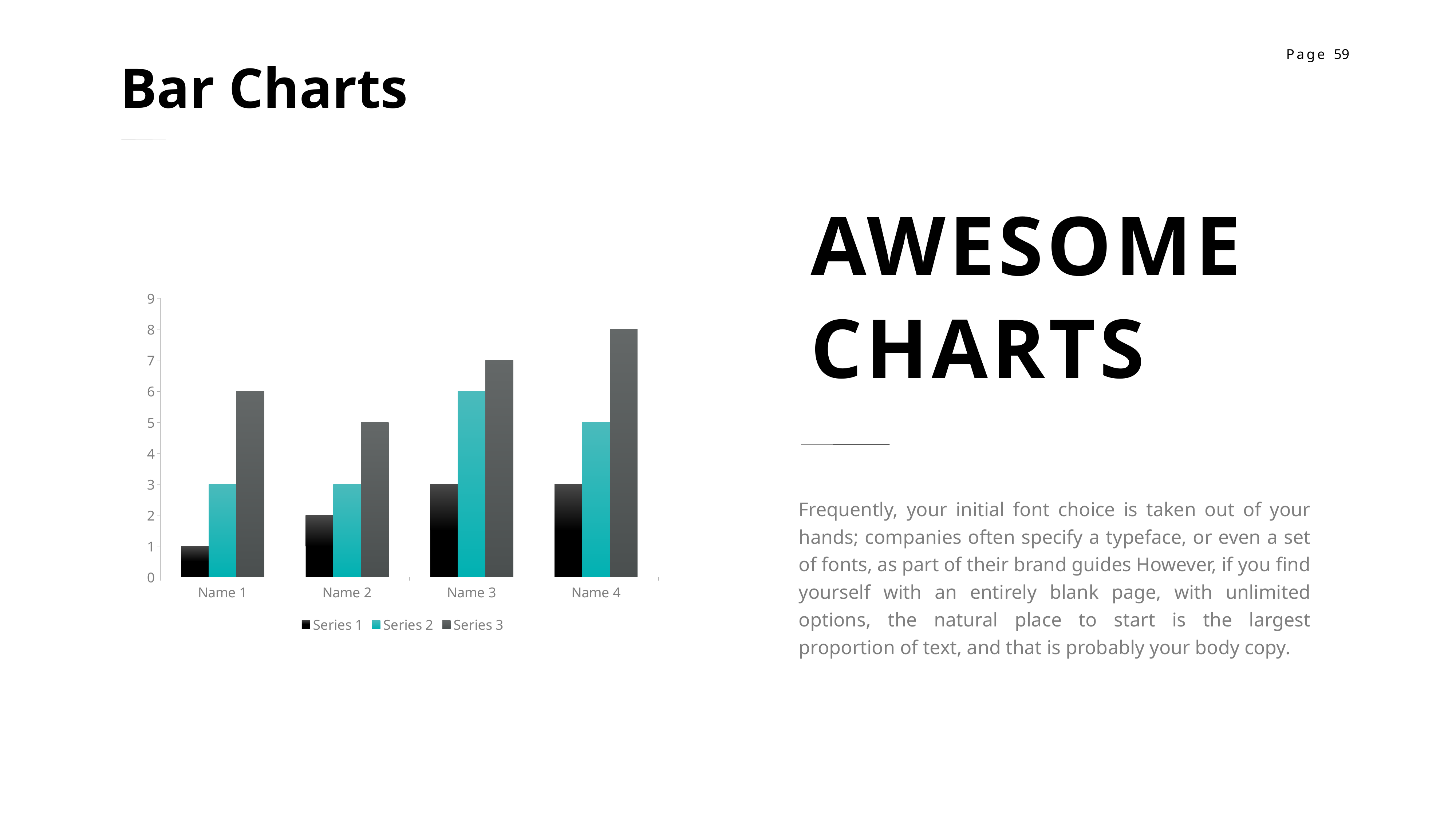
What is the value of Series 2 for Name 3? 6 How many series does the legend list? 3 How many categories are shown on the x axis? 4 Which series is shown in teal in the legend? Series 2 What kind of chart is shown on the slide? bar chart What is the value of Series 1 for Name 1? 1 What is the value of Series 3 for Name 4? 8 Is the value of Series 3 for Name 3 greater or less than 5? greater Which category has the lowest Series 1 value? Name 1 What is the difference between the Series 3 and Series 1 values for Name 1? 5 For Name 2, which is larger: Series 2 or Series 3? Series 3 Which category has the highest Series 3 value? Name 4